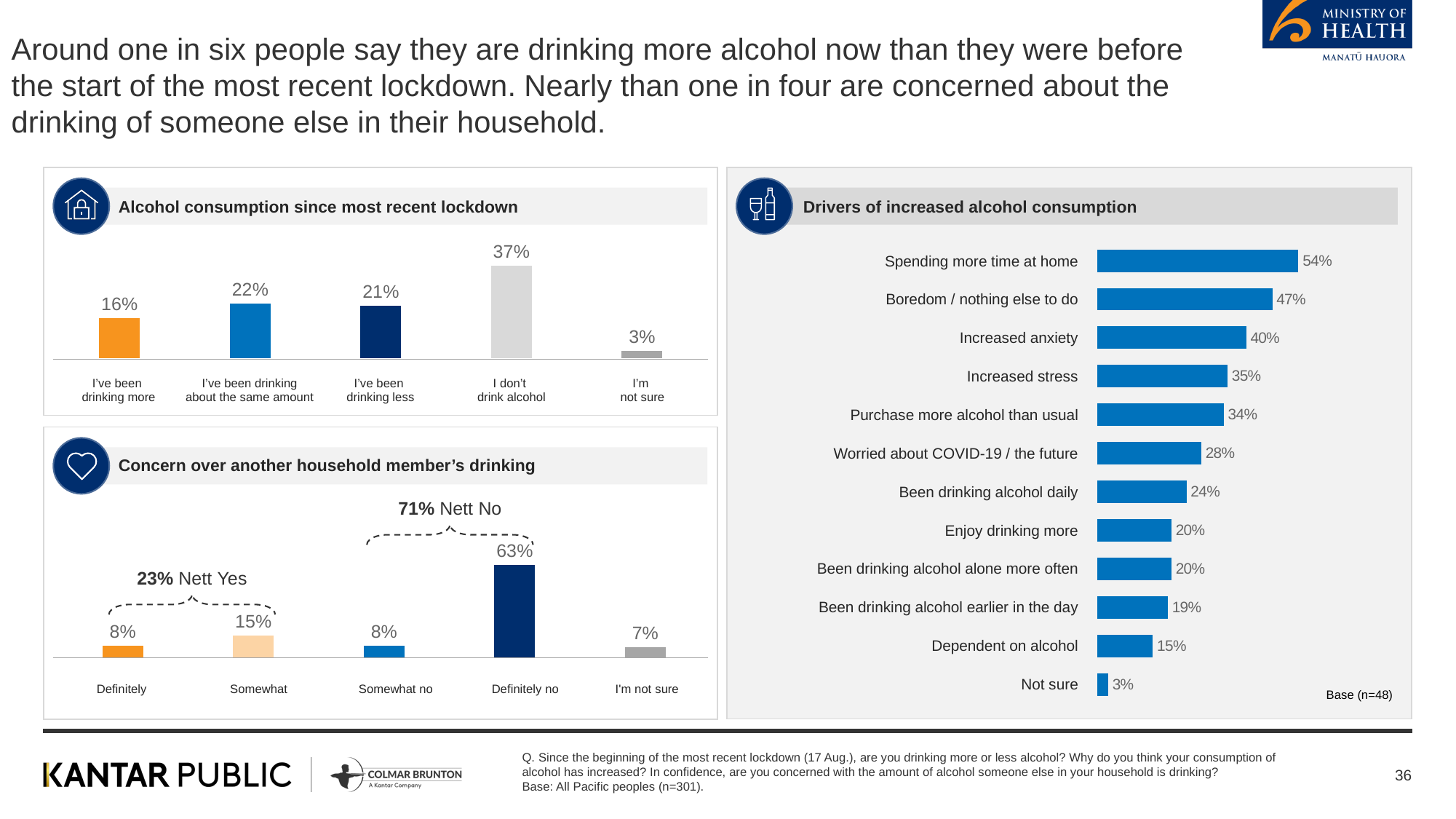
In the 'Alcohol consumption since most recent lockdown' chart, which category has the highest value? I don't drink alcohol In the 'Alcohol consumption since most recent lockdown' chart, how many categories are shown? 5 In the 'Drivers of increased alcohol consumption' chart, which driver has the highest value? Spending more time at home In the 'Drivers of increased alcohol consumption' chart, which category has the lowest value? Not sure In the 'Drivers of increased alcohol consumption' chart, what is the value for 'Increased anxiety'? 40% In the 'Concern over another household member's drinking' chart, what is the Nett Yes figure? 23% In the 'Alcohol consumption since most recent lockdown' chart, what is the difference between 'I've been drinking about the same amount' and 'I've been drinking less'? 1% In the 'Drivers of increased alcohol consumption' chart, what is the difference between 'Spending more time at home' and 'Boredom / nothing else to do'? 7% In the 'Concern over another household member's drinking' chart, what is the value for 'Definitely no'? 63% In the 'Concern over another household member's drinking' chart, which is larger: 'Somewhat' or 'Somewhat no'? Somewhat In the 'Alcohol consumption since most recent lockdown' chart, what percentage say they've been drinking more? 16% What type of chart is the 'Drivers of increased alcohol consumption' chart? Bar chart